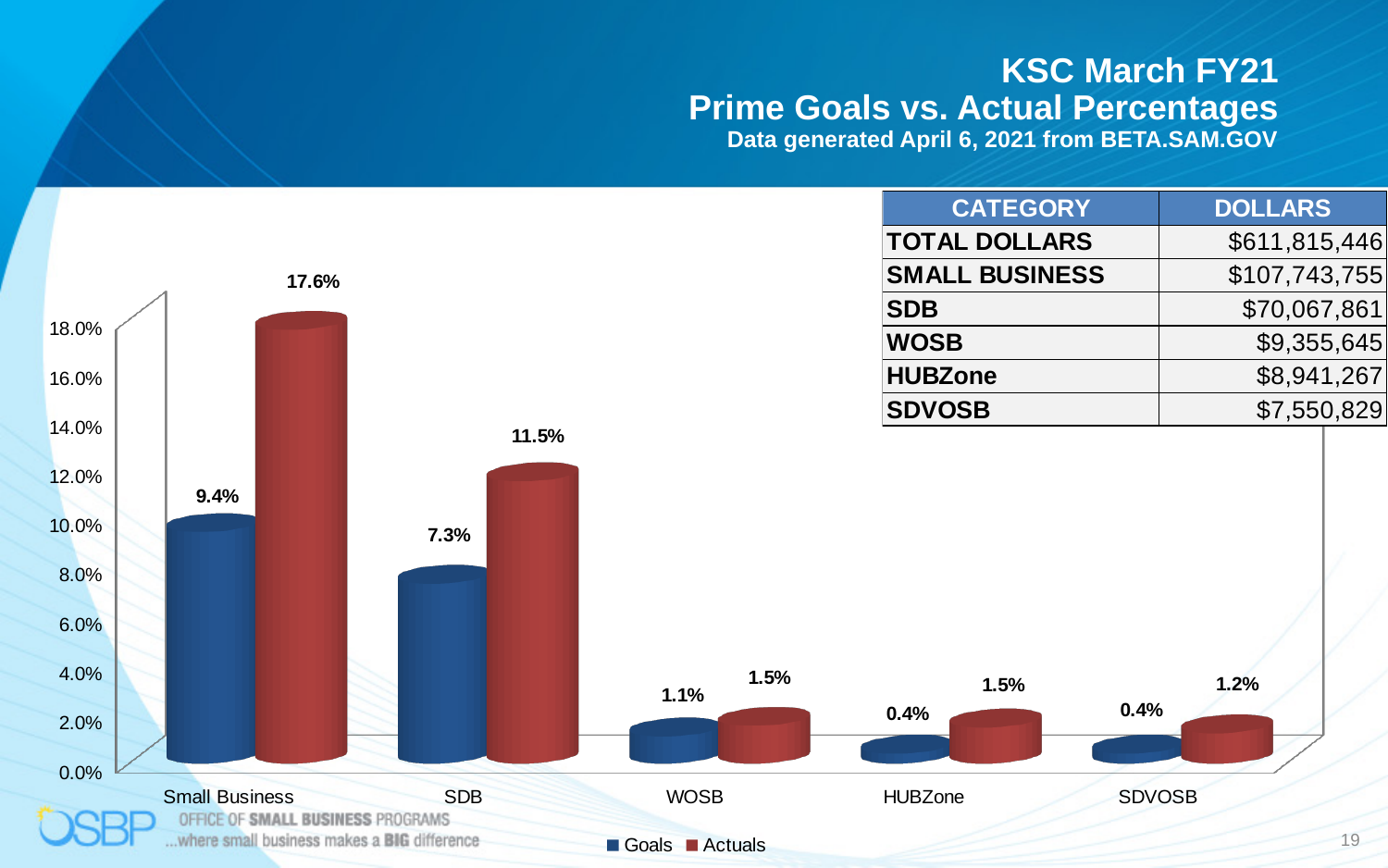
Which category has the highest Actuals value? Small Business What is the Actuals value for SDVOSB? 1.2% What is the Goals value for SDB? 7.3% Which category has the lowest Actuals value? SDVOSB Which colour represents the Actuals series in the chart? Red How many series does the legend list? 2 How many categories are shown on the x axis? 5 What is the difference between the Actuals and Goals values for SDB? 4.2% What is the difference between the Actuals and Goals values for Small Business? 8.2% What kind of chart is shown on the slide? Bar chart Which is larger, the Goals value for WOSB or the Goals value for HUBZone? WOSB What is the Actuals value for Small Business? 17.6%